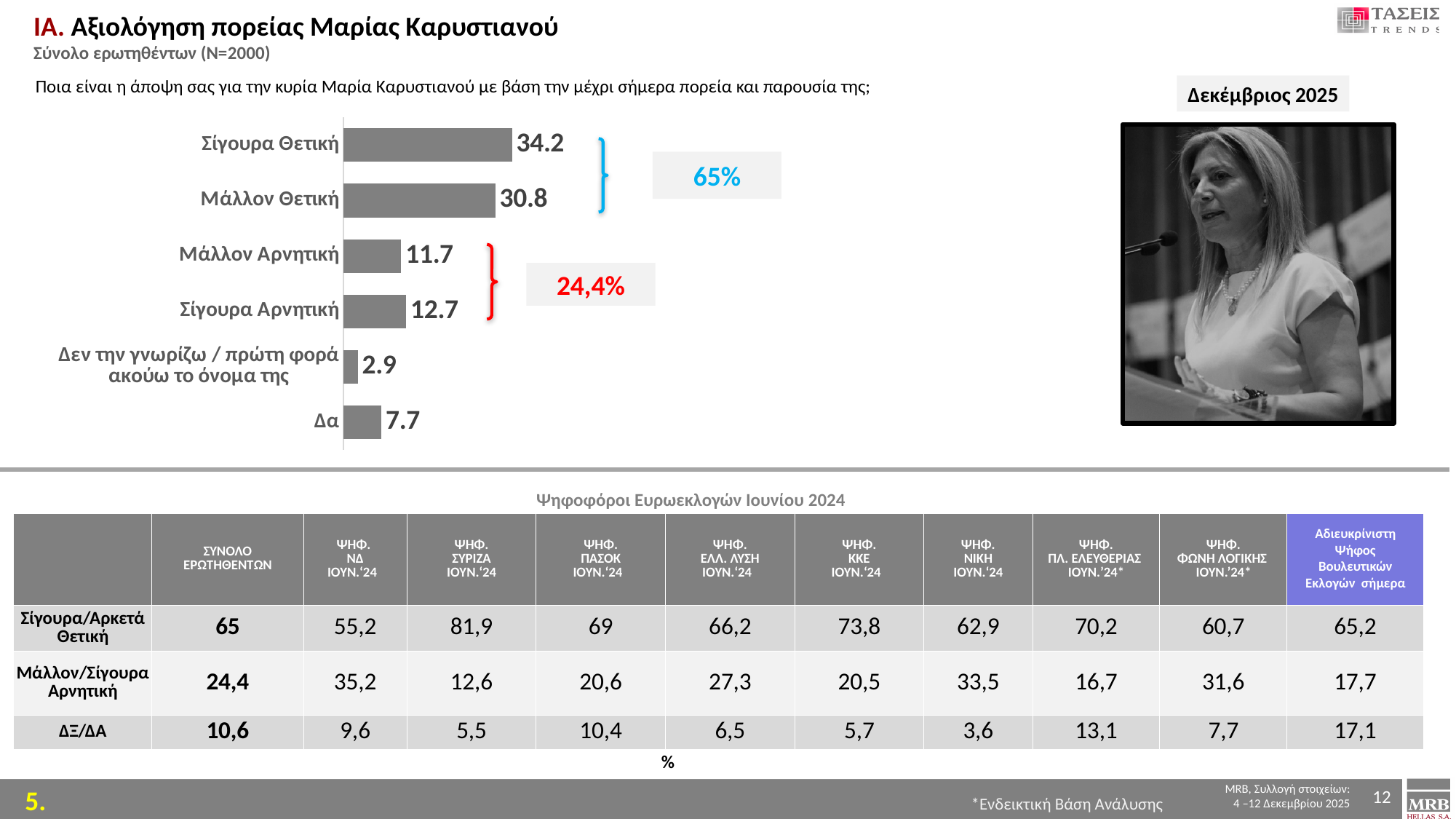
What is the value for Σίγουρα Αρνητική in the bar chart? 12.7 What kind of chart is shown on the slide? Bar chart What is the value for Μάλλον Θετική in the bar chart? 30.8 What is the value for Δεν την γνωρίζω / πρώτη φορά ακούω το όνομα της in the bar chart? 2.9 What is the difference between the values for Σίγουρα Θετική and Μάλλον Θετική in the bar chart? 3.4 Which category has the lowest value in the bar chart? Δεν την γνωρίζω / πρώτη φορά ακούω το όνομα της What combined percentage is shown next to the blue bracket grouping Σίγουρα Θετική and Μάλλον Θετική? 65% What is the value for Σίγουρα Θετική in the bar chart? 34.2 How many categories are shown in the bar chart? 6 Which is larger in the bar chart: Μάλλον Αρνητική or Σίγουρα Αρνητική? Σίγουρα Αρνητική What combined percentage is shown next to the red bracket grouping Μάλλον Αρνητική and Σίγουρα Αρνητική? 24,4% Which category has the highest value in the bar chart? Σίγουρα Θετική